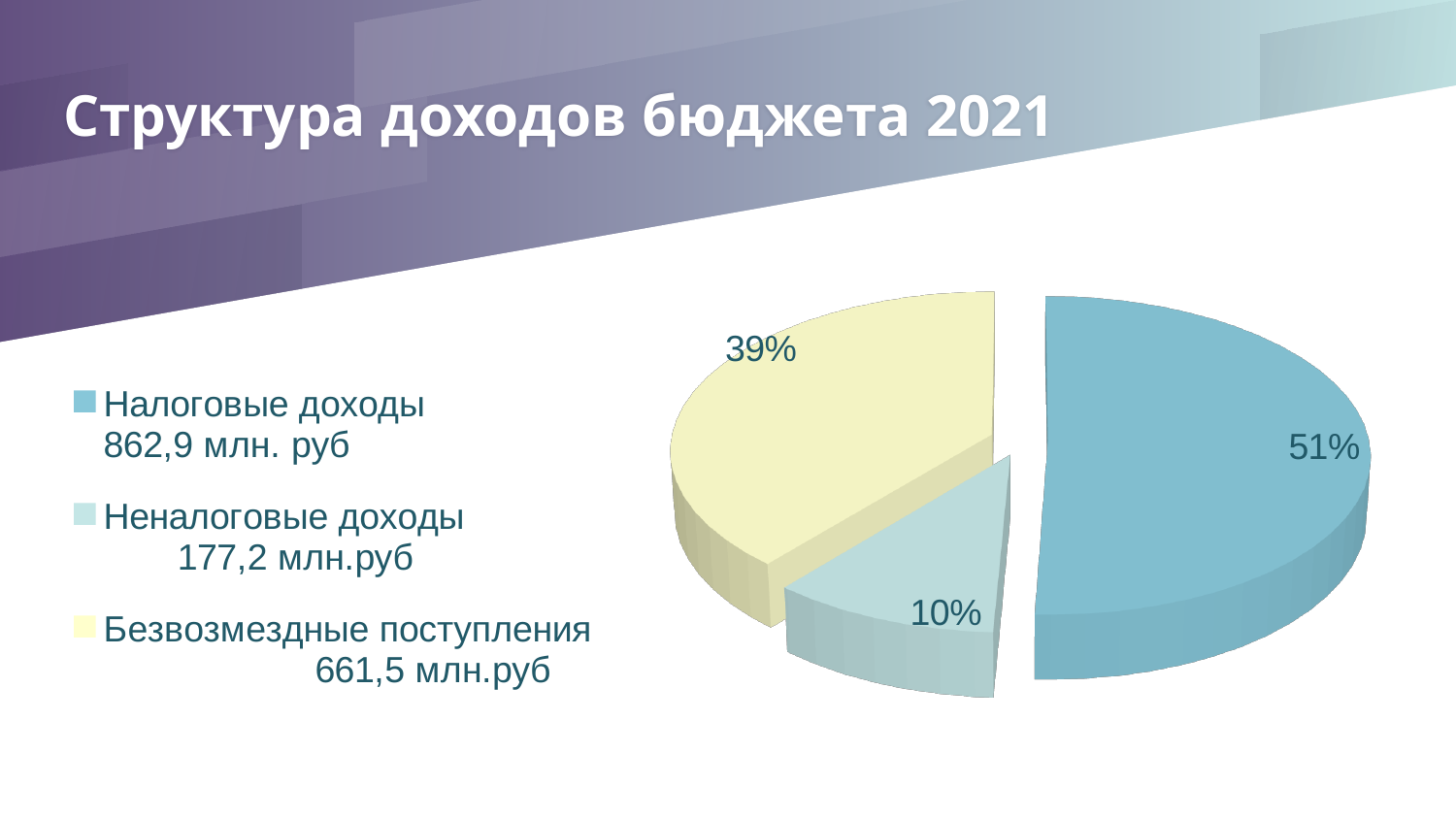
What is the title of the slide containing the chart? Структура доходов бюджета 2021 What share of the pie does Налоговые доходы take? 51% Which category has the largest slice of the pie? Налоговые доходы How many slices does the pie chart have? 3 What amount is shown in the legend for Неналоговые доходы? 177,2 млн.руб What kind of chart is shown on the slide? pie chart What amount is shown in the legend for Налоговые доходы? 862,9 млн. руб By how many percentage points does the share of Налоговые доходы exceed the share of Безвозмездные поступления? 12 percentage points What amount is shown in the legend for Безвозмездные поступления? 661,5 млн.руб What share of the pie does Безвозмездные поступления take? 39% What share of the pie does Неналоговые доходы take? 10% Which category has the smallest slice of the pie? Неналоговые доходы